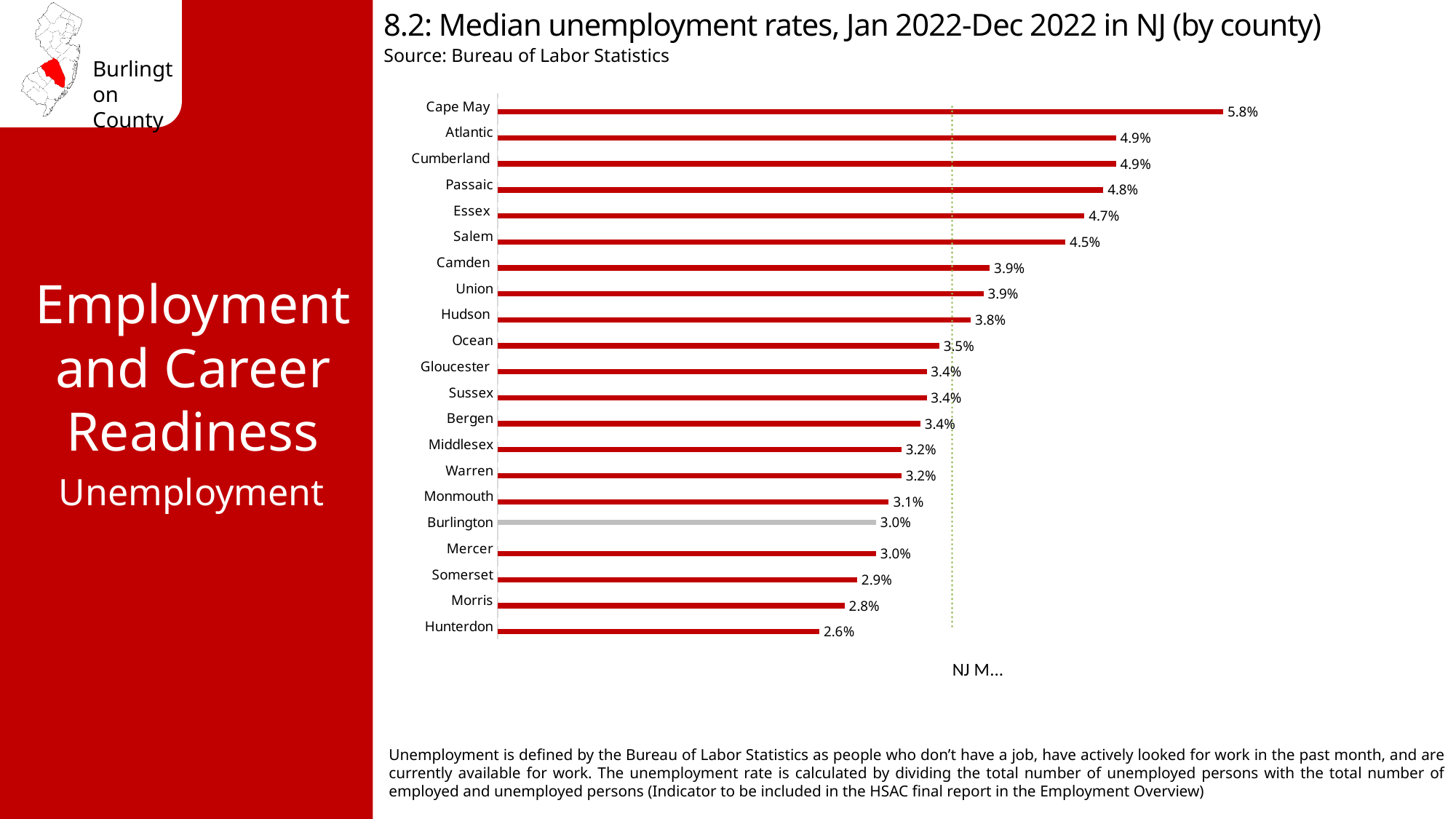
Which county has a higher median unemployment rate, Camden or Monmouth? Camden What is the median unemployment rate for Burlington? 3.0% What type of chart is used to show the median unemployment rates? Bar chart What is the median unemployment rate for Cape May? 5.8% Which county has the highest median unemployment rate? Cape May What is the difference between the median unemployment rates of Essex and Burlington? 1.7% Which county's bar is shown in grey rather than red? Burlington What is the difference between the median unemployment rates of Cape May and Hunterdon? 3.2% What is the median unemployment rate for Hunterdon? 2.6% How many counties are shown in the chart? 21 Which county has the lowest median unemployment rate? Hunterdon What is the median unemployment rate for Salem? 4.5%